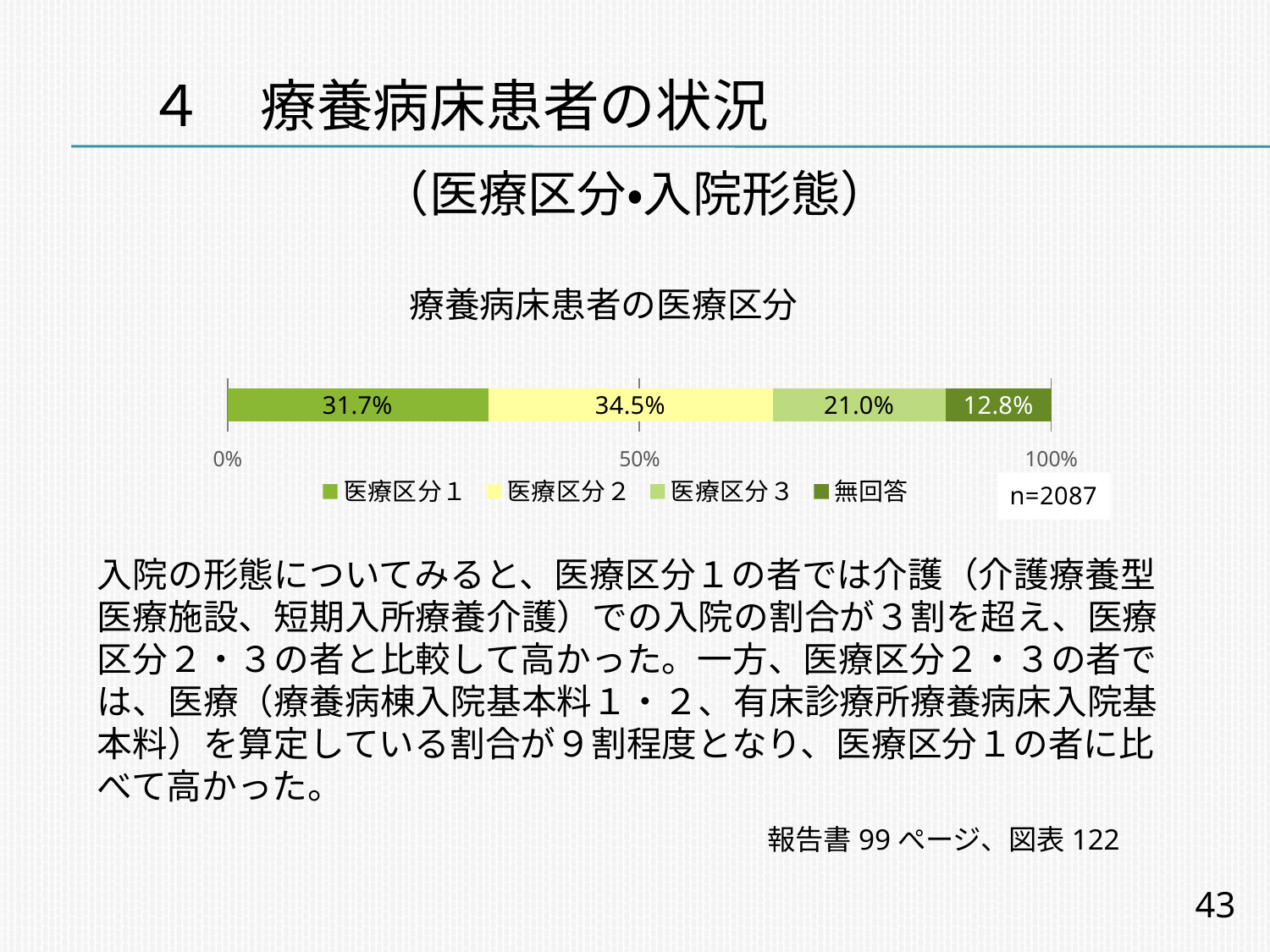
What is the difference between the values for 医療区分２ and 医療区分１? 2.8% How many series does the legend list? 4 What is the value for 無回答 in the chart? 12.8% Which segment has the smallest share in the chart? 無回答 What is the value for 医療区分３ in the chart? 21.0% What is the sample size (n) shown next to the chart? n=2087 Which segment has the largest share in the chart? 医療区分２ What is the value for 医療区分１ in the chart? 31.7% What is the title of the chart? 療養病床患者の医療区分 What is the value for 医療区分２ in the chart? 34.5% What kind of chart is shown on the slide? Stacked bar chart Which is larger, the value for 医療区分３ or the value for 無回答? 医療区分３